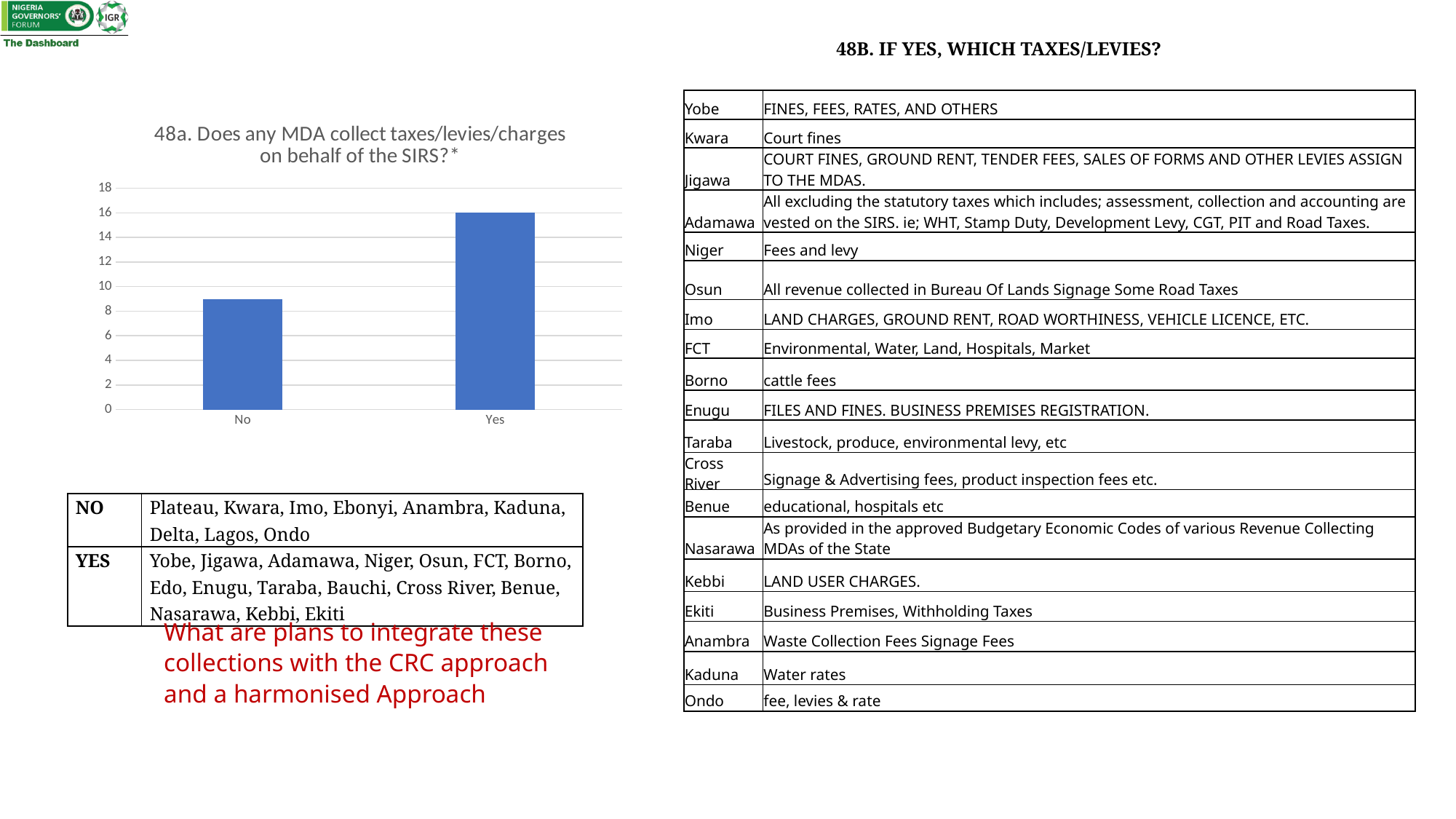
Which is larger in the chart, the value for No or the value for Yes? Yes Which category has the lowest value in the chart? No Is the value for No greater or less than 6? greater Is the value for Yes greater or less than 14? greater What is the title of the chart? 48a. Does any MDA collect taxes/levies/charges on behalf of the SIRS?* Which category has the highest value in the chart? Yes Is the value for No greater or less than 10? less What is the value for Yes in the chart? 16 What is the highest value shown on the chart's vertical axis? 18 What kind of chart is shown on the slide? bar chart How many categories are plotted on the x axis of the chart? 2